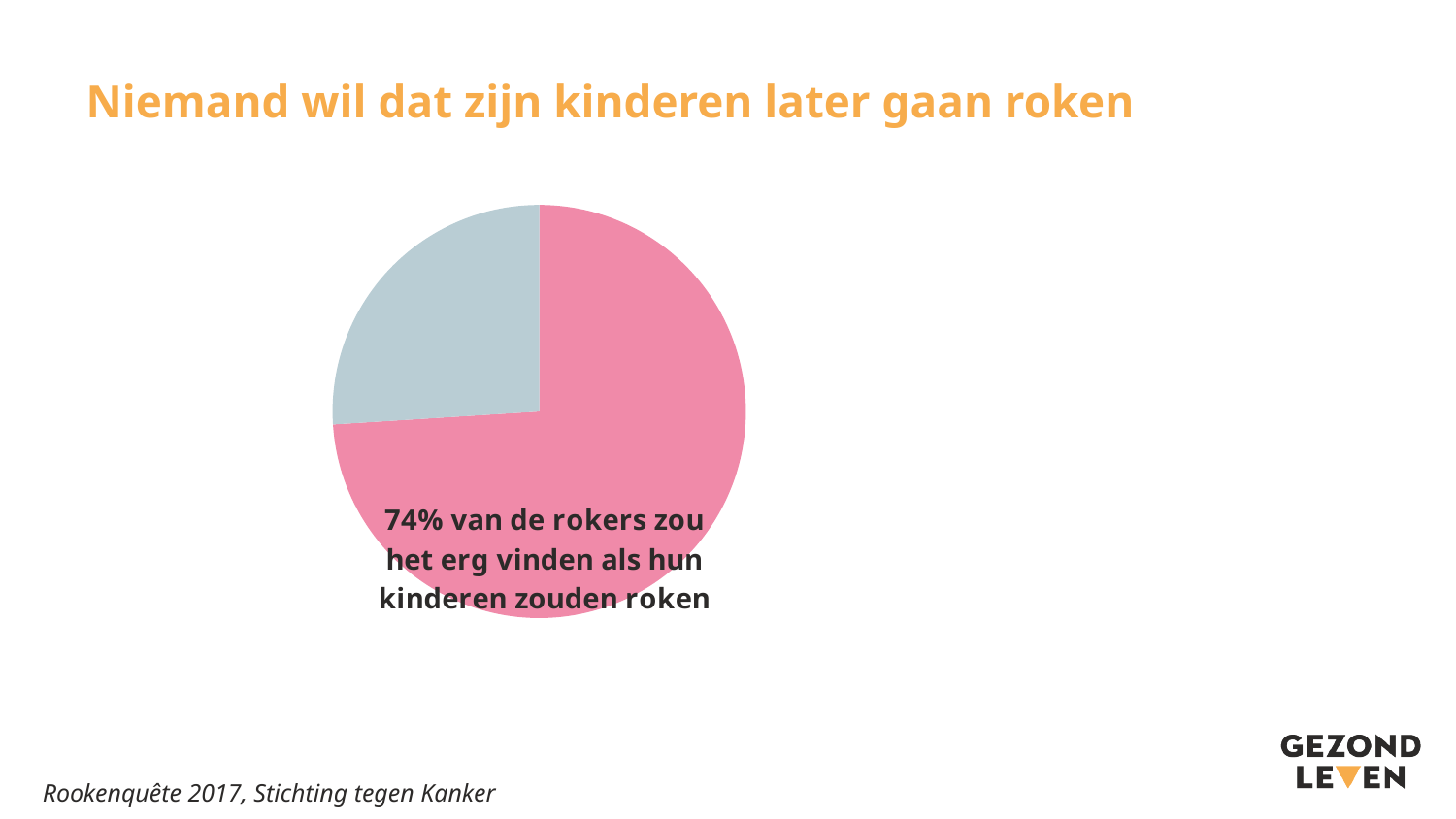
What share of smokers would mind if their children smoked, according to the pie chart? 74% Which slice of the pie chart is larger, the pink one or the grey one? the pink one What is the title of the slide containing the pie chart? Niemand wil dat zijn kinderen later gaan roken What kind of chart is shown on the slide? pie chart Is the pink slice of the pie chart greater or less than half of the pie? greater How many slices does the pie chart have? 2 What colour is the slice labelled 74% in the pie chart? pink